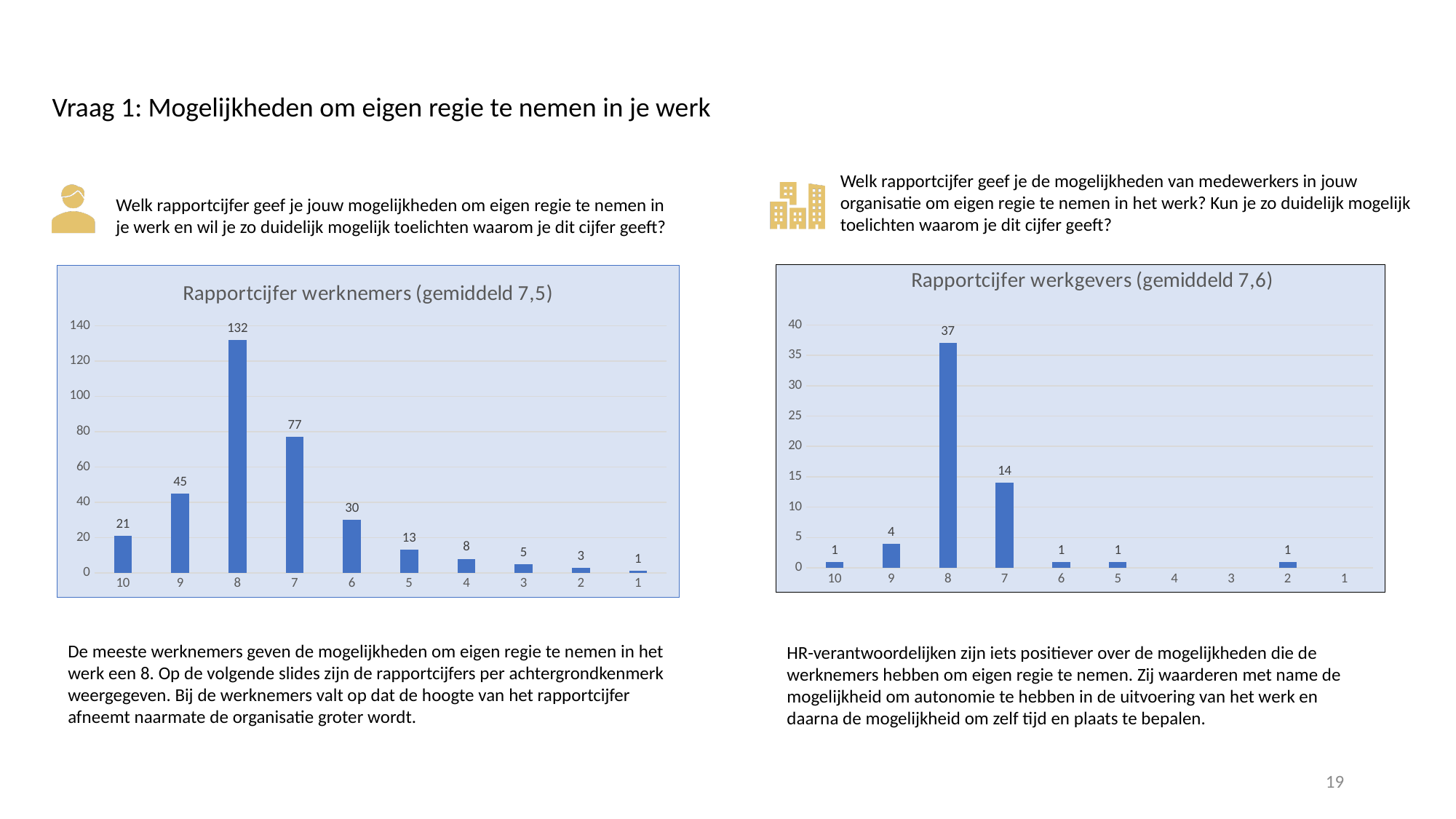
In the 'Rapportcijfer werkgevers (gemiddeld 7,6)' chart, which grade has the highest value? 8 In the 'Rapportcijfer werknemers (gemiddeld 7,5)' chart, which grade has the lowest value? 1 In the 'Rapportcijfer werkgevers (gemiddeld 7,6)' chart, what is the difference between the values for grade 8 and grade 7? 23 How many grade categories are shown on the x axis of the 'Rapportcijfer werkgevers (gemiddeld 7,6)' chart? 10 What type of chart is the 'Rapportcijfer werknemers (gemiddeld 7,5)' chart? bar chart In the 'Rapportcijfer werknemers (gemiddeld 7,5)' chart, which grade has the highest value? 8 In the 'Rapportcijfer werknemers (gemiddeld 7,5)' chart, what is the difference between the values for grade 8 and grade 7? 55 In the 'Rapportcijfer werknemers (gemiddeld 7,5)' chart, which is larger: the value for grade 9 or the value for grade 6? grade 9 In the 'Rapportcijfer werknemers (gemiddeld 7,5)' chart, what is the value for grade 8? 132 In the 'Rapportcijfer werkgevers (gemiddeld 7,6)' chart, what is the value for grade 7? 14 In the 'Rapportcijfer werknemers (gemiddeld 7,5)' chart, what is the value for grade 6? 30 In the 'Rapportcijfer werkgevers (gemiddeld 7,6)' chart, what is the value for grade 9? 4